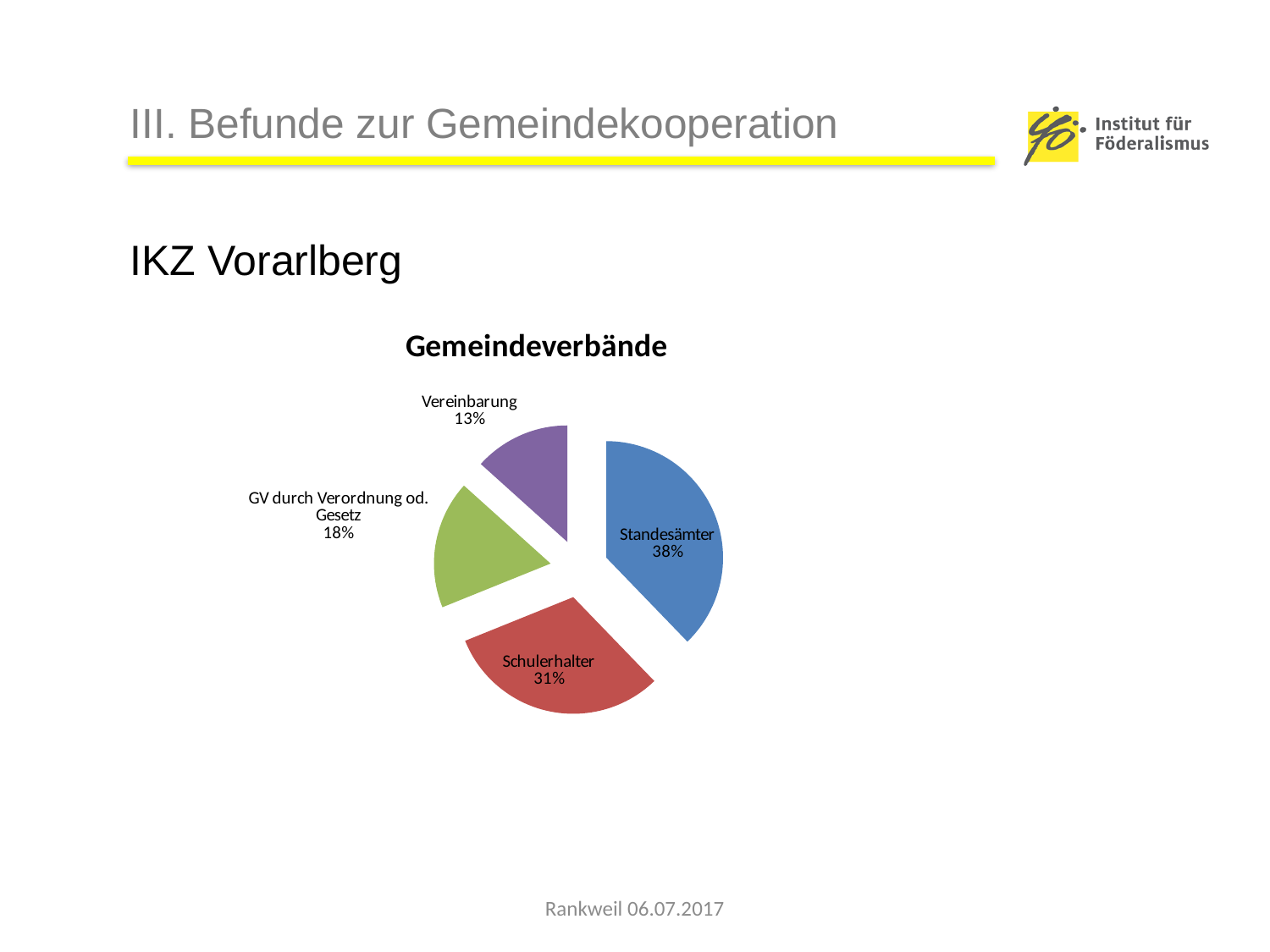
What colour is the Schulerhalter slice? red What share of the pie does Vereinbarung have? 13% What share of the pie does Standesämter have? 38% What share of the pie does GV durch Verordnung od. Gesetz have? 18% Which is larger, the share for GV durch Verordnung od. Gesetz or the share for Vereinbarung? GV durch Verordnung od. Gesetz What is the difference in percentage points between Standesämter and Schulerhalter? 7 Which category has the smallest share of the pie? Vereinbarung What kind of chart is shown on the slide? pie chart How many slices does the pie chart have? 4 Which category has the largest share of the pie? Standesämter What is the title of the chart? Gemeindeverbände